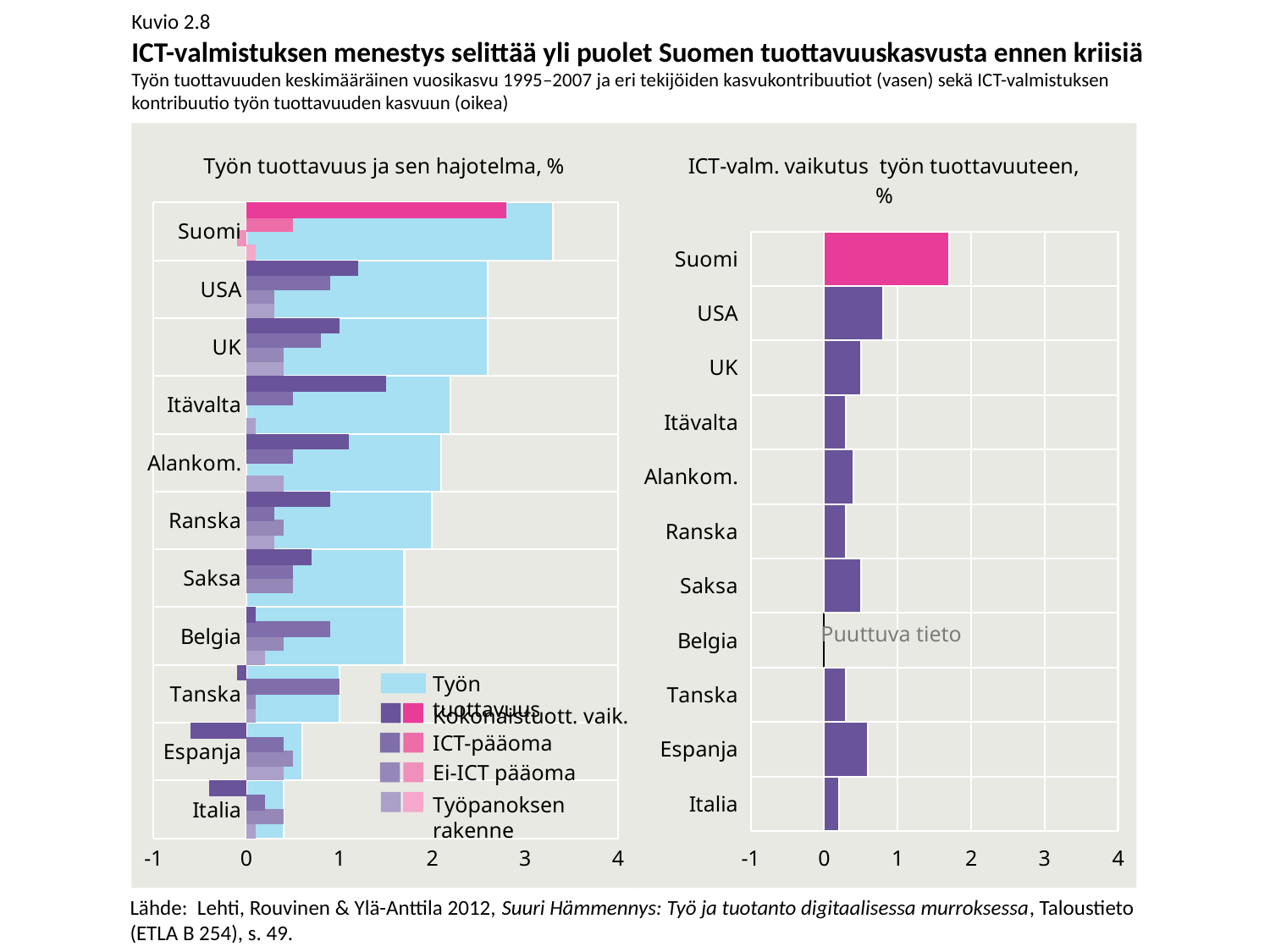
How many countries are shown on the left chart, 'Työn tuottavuus ja sen hajotelma, %'? 11 On the left chart, 'Työn tuottavuus ja sen hajotelma, %', is the Työn tuottavuus value for Saksa greater or less than 2? less On the right chart, 'ICT-valm. vaikutus työn tuottavuuteen, %', which is larger, the value for USA or the value for UK? USA On the right chart, 'ICT-valm. vaikutus työn tuottavuuteen, %', which country has the highest value? Suomi What kind of chart is the left chart, 'Työn tuottavuus ja sen hajotelma, %'? bar chart How many series does the legend of the left chart, 'Työn tuottavuus ja sen hajotelma, %', list? 5 On the left chart, 'Työn tuottavuus ja sen hajotelma, %', is the Työn tuottavuus value for Suomi greater or less than 3? greater On the left chart, 'Työn tuottavuus ja sen hajotelma, %', which country has the lowest Työn tuottavuus value? Italia On the left chart, 'Työn tuottavuus ja sen hajotelma, %', which country has the highest Työn tuottavuus value? Suomi On the right chart, 'ICT-valm. vaikutus työn tuottavuuteen, %', is the value for USA greater or less than 1? less On the right chart, 'ICT-valm. vaikutus työn tuottavuuteen, %', what text is shown in place of a bar for Belgia? Puuttuva tieto